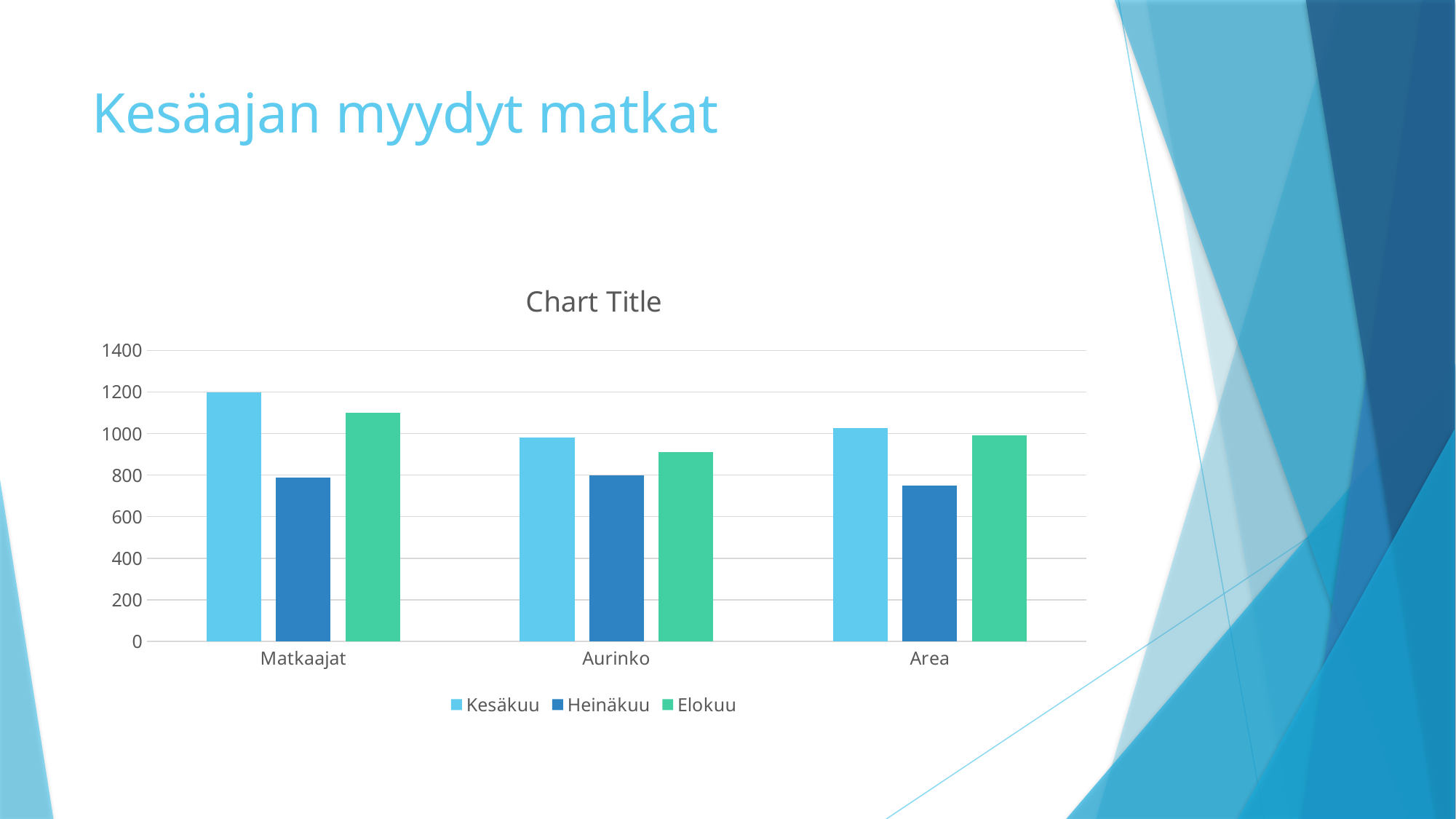
Is the Elokuu value for Matkaajat greater or less than 1000? greater How many categories are shown on the x axis of the chart? 3 For Aurinko, which is larger: the Heinäkuu value or the Elokuu value? Elokuu What kind of chart is shown on the slide? bar chart How many series does the chart's legend list? 3 What are the three series listed in the chart's legend? Kesäkuu, Heinäkuu, Elokuu Which category has the highest Kesäkuu value? Matkaajat For Matkaajat, which is larger: the Kesäkuu value or the Elokuu value? Kesäkuu Which category has the lowest Heinäkuu value? Area Is the Heinäkuu value for Area greater or less than 800? less What is the Kesäkuu value for Matkaajat? 1200